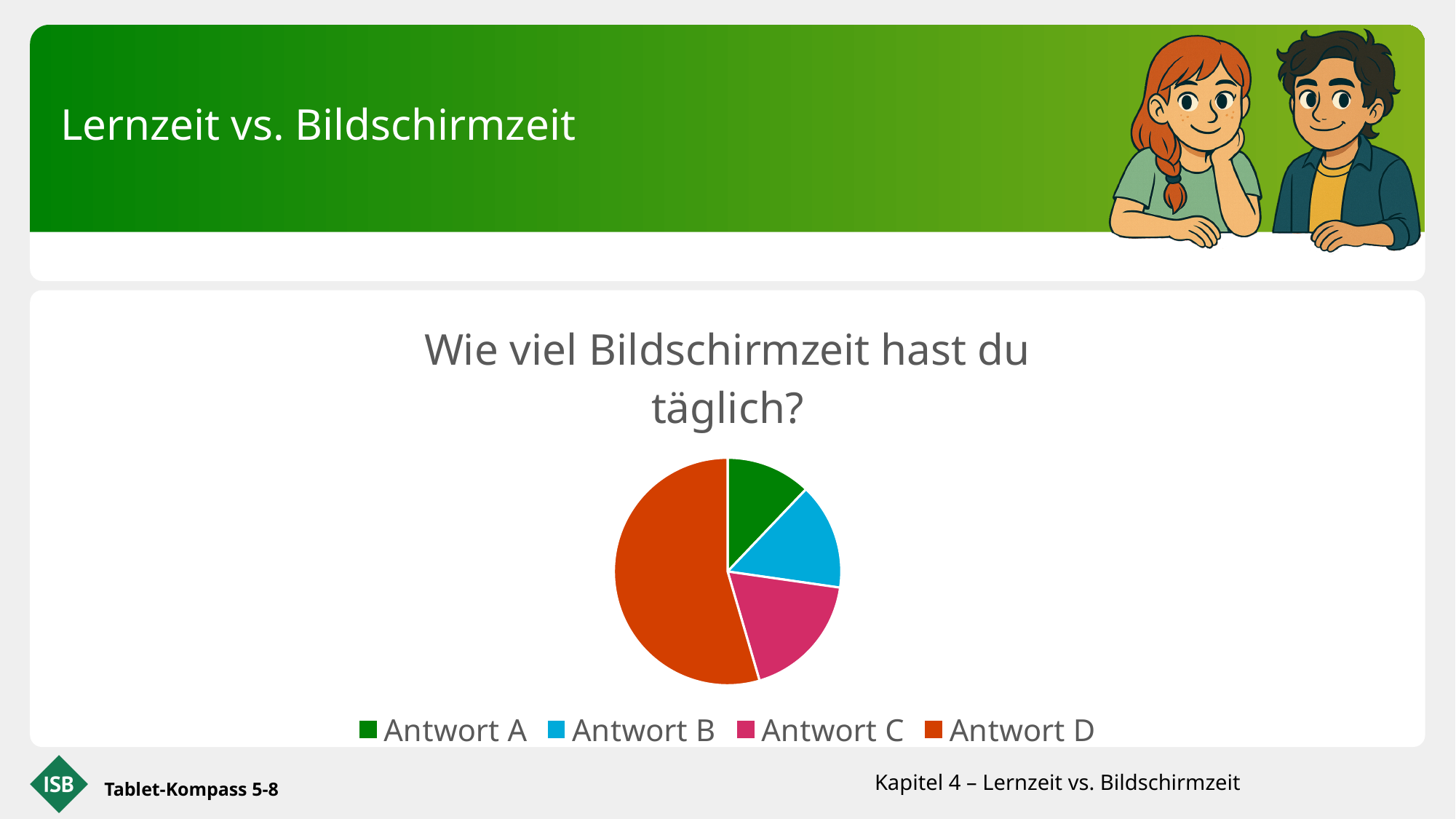
Which answer has the smallest slice of the pie? Antwort A How many entries does the legend list? 4 Which slice is larger, Antwort A or Antwort D? Antwort D What kind of chart is shown on the slide? pie chart Which answer has the largest slice of the pie? Antwort D How many slices does the pie chart have? 4 Which slice is larger, Antwort B or Antwort D? Antwort D Which slice is larger, Antwort D or Antwort C? Antwort D Which colour represents Antwort D in the pie chart? orange What is the title of the chart? Wie viel Bildschirmzeit hast du täglich?